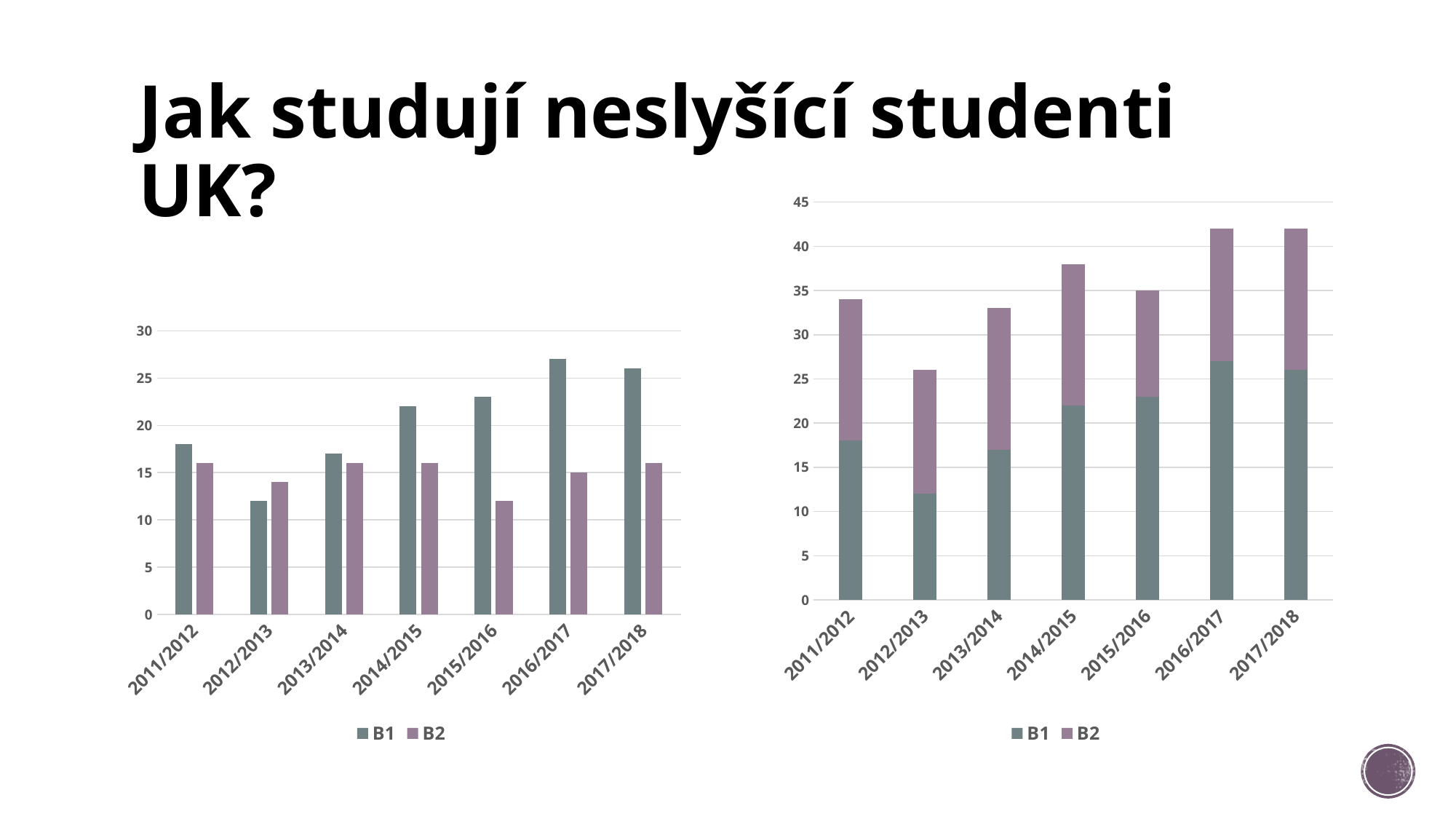
In the chart on the left, which year has the lowest B1 value? 2012/2013 In the chart on the left, how many academic years are shown on the x axis? 7 In the chart on the left, what are the two series named in the legend? B1 and B2 What kind of chart is the chart on the right of the slide? stacked bar chart In the chart on the right, is the total for 2014/2015 greater or less than 35? greater In the chart on the right, which year has the lowest total stacked bar? 2012/2013 What kind of chart is the chart on the left of the slide? bar chart In the chart on the left, for 2016/2017, which is larger, B1 or B2? B1 In the chart on the left, is the B1 value for 2016/2017 greater or less than 25? greater In the chart on the right, how many series does the legend list? 2 In the chart on the left, is the B1 value for 2012/2013 greater or less than 15? less In the chart on the left, for 2012/2013, which is larger, B1 or B2? B2